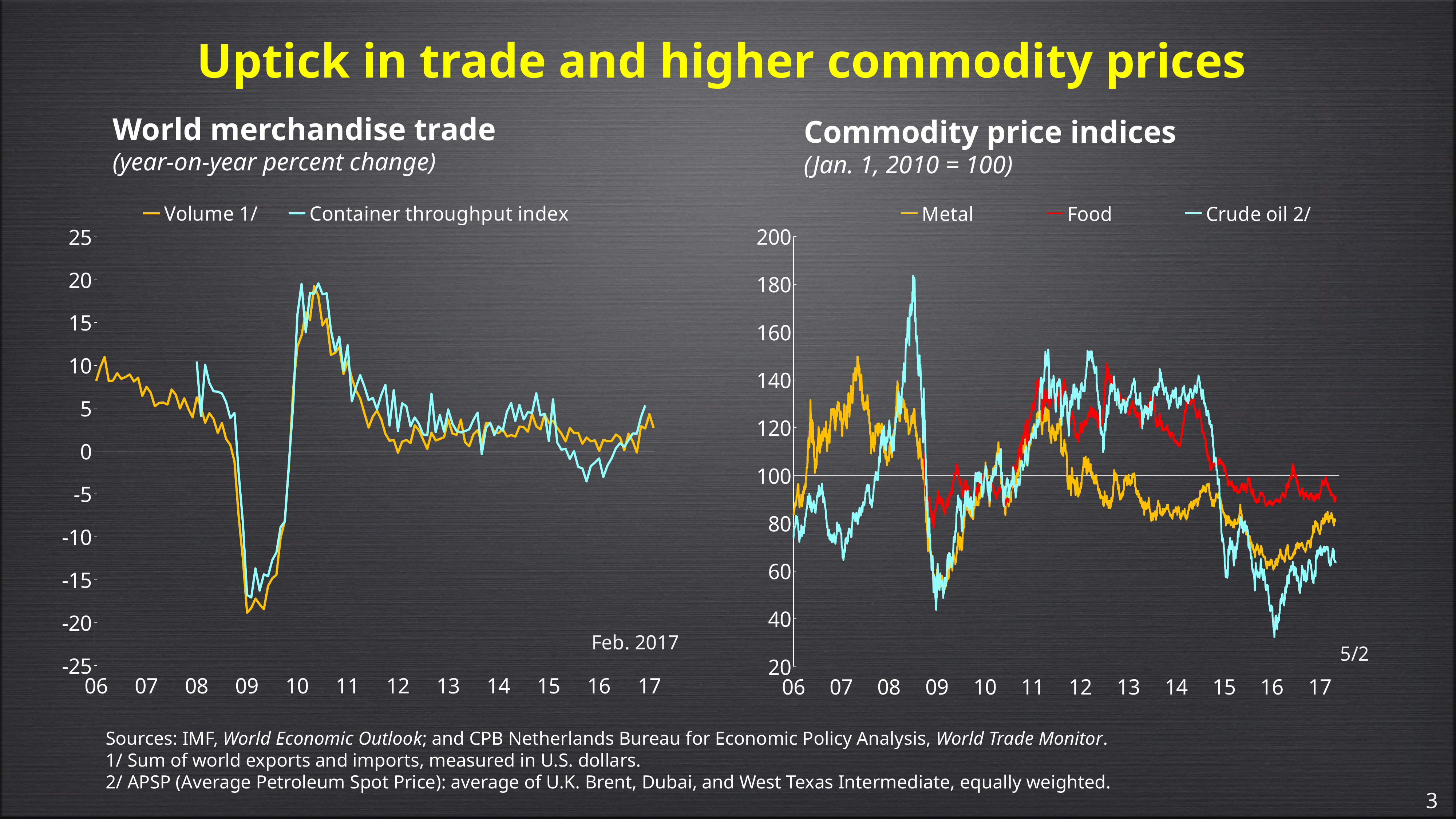
In the 'Commodity price indices' chart, is the peak value of Crude oil 2/ in 2008 greater or less than 160? greater In the 'World merchandise trade' chart, is the lowest value of the Volume 1/ series in 2009 greater or less than -15? less In the 'World merchandise trade' chart, is the peak value of the Container throughput index around 2010 greater or less than 15? greater How many series does the legend of the 'Commodity price indices' chart list? 3 In the 'Commodity price indices' chart, which series falls to the lowest value over the whole period? Crude oil 2/ In the 'Commodity price indices' chart, does the Crude oil 2/ series rise or fall between mid-2014 and early 2016? fall In the 'Commodity price indices' chart, which series reaches the highest value over the whole period? Crude oil 2/ What colour is the Food series line in the 'Commodity price indices' chart? red How many series does the legend of the 'World merchandise trade' chart list? 2 What kind of chart is the 'World merchandise trade' chart? line chart